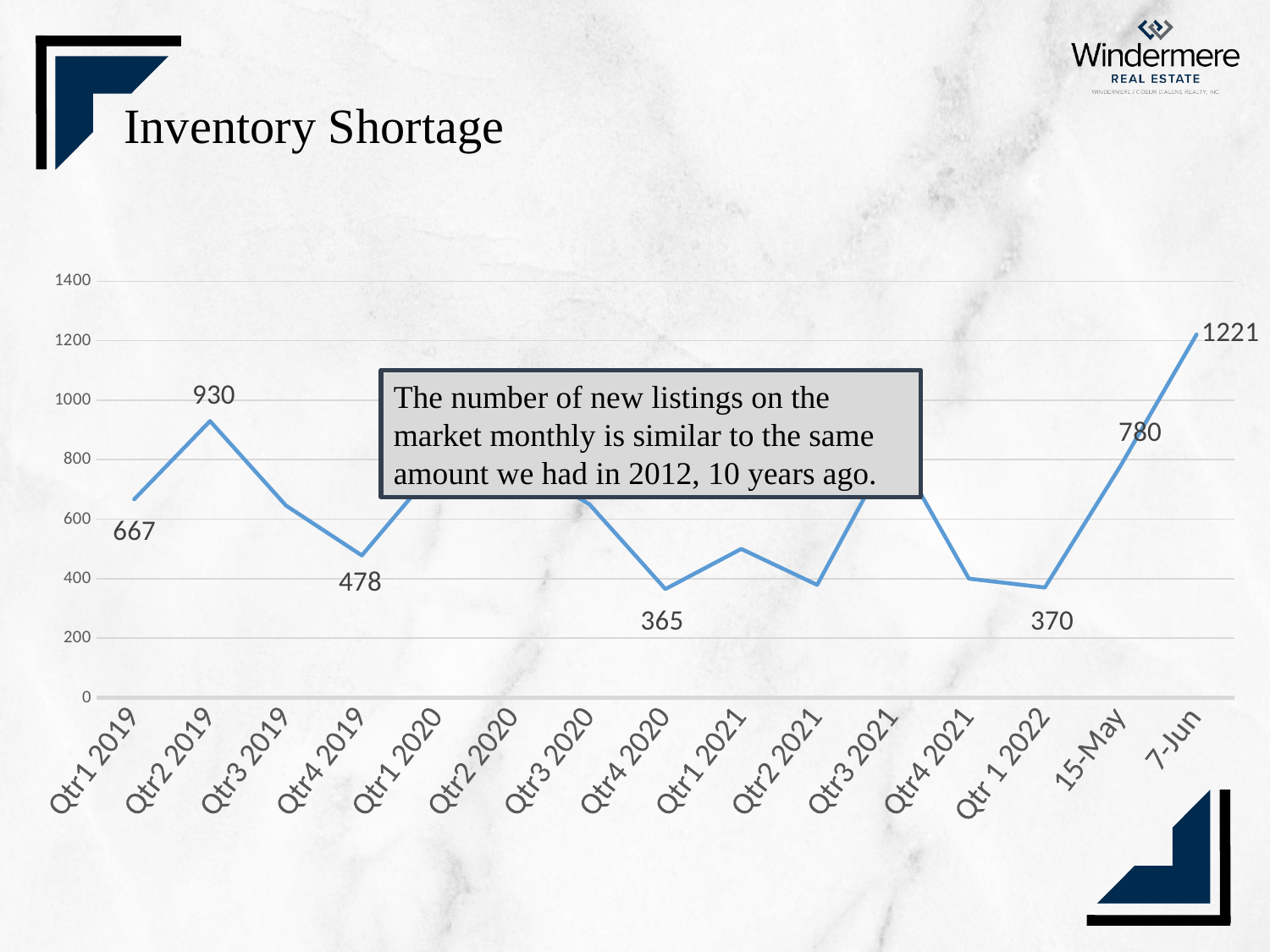
What kind of chart is shown on the slide? line chart How many categories are shown on the x axis? 15 What is the value for 7-Jun? 1221 Is the value for Qtr1 2021 greater or less than 400? greater What is the difference between the values for 7-Jun and 15-May? 441 Which is larger, the value for Qtr2 2019 or the value for 15-May? Qtr2 2019 What is the value for 15-May? 780 Which category has the highest value? 7-Jun What is the value for Qtr2 2019? 930 Do the values rise or fall from Qtr 1 2022 to 7-Jun? rise What is the difference between the values for Qtr2 2019 and Qtr1 2019? 263 What is the value for Qtr4 2020? 365